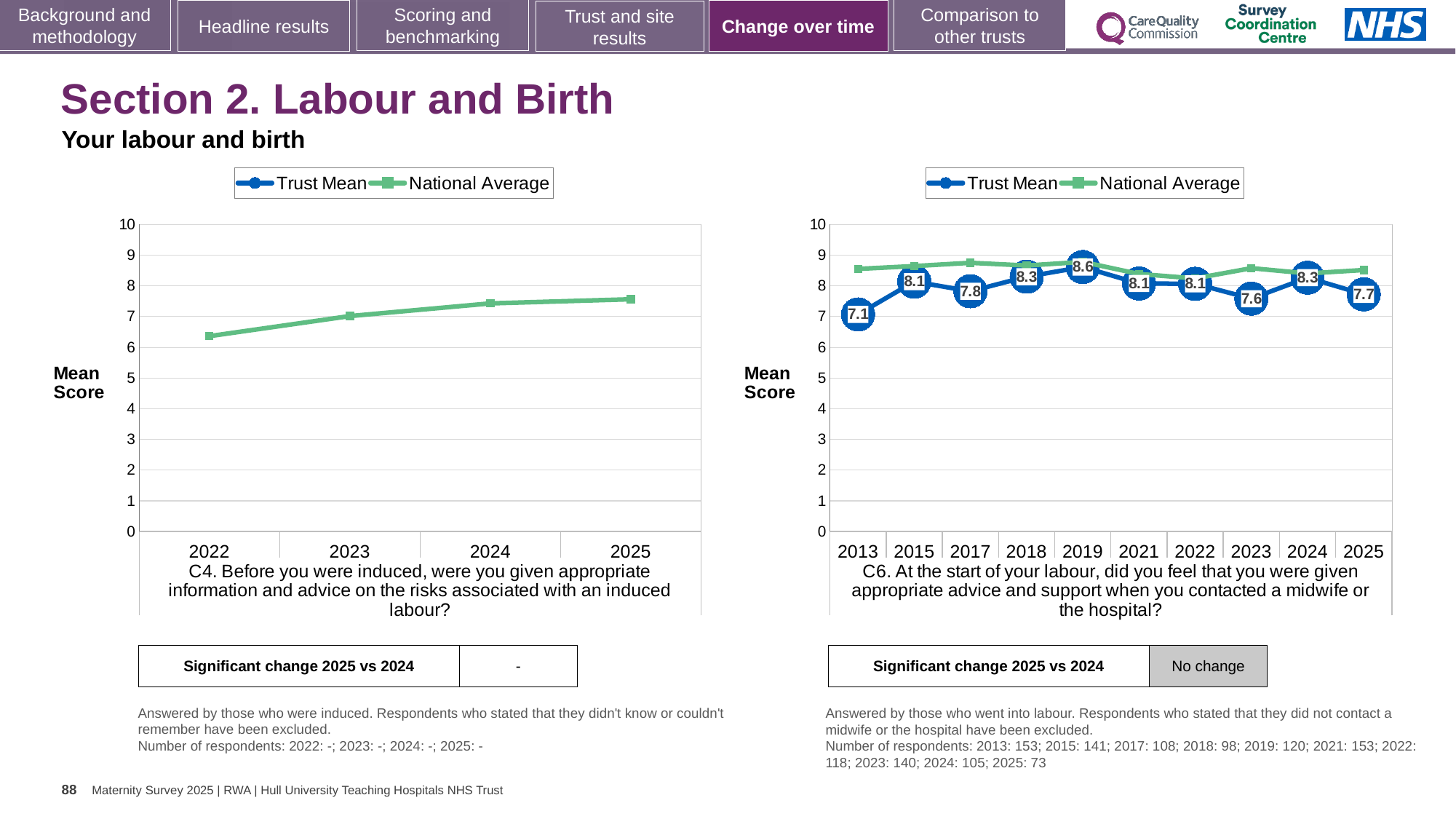
In the C6 chart on the right, what is the difference between the Trust Mean scores for 2024 and 2025? 0.6 In the C6 chart on the right, which year has the lowest Trust Mean score? 2013 In the C4 chart on the left, is the National Average value for 2022 greater or less than 7? less In the C6 chart on the right, what is the Trust Mean score for 2019? 8.6 In the C4 chart on the left, does the National Average line rise or fall from 2022 to 2025? rise In the C6 chart on the right, is the Trust Mean score for 2018 or 2023 larger? 2018 In the C4 chart on the left, is the National Average value for 2025 greater or less than 7? greater In the C6 chart on the right, what is the Trust Mean score for 2025? 7.7 In the C6 chart on the right, how many years are shown on the x axis? 10 How many series does the legend of the C4 chart on the left list? 2 In the C6 chart on the right, what is the Trust Mean score for 2013? 7.1 In the C6 chart on the right, which year has the highest Trust Mean score? 2019